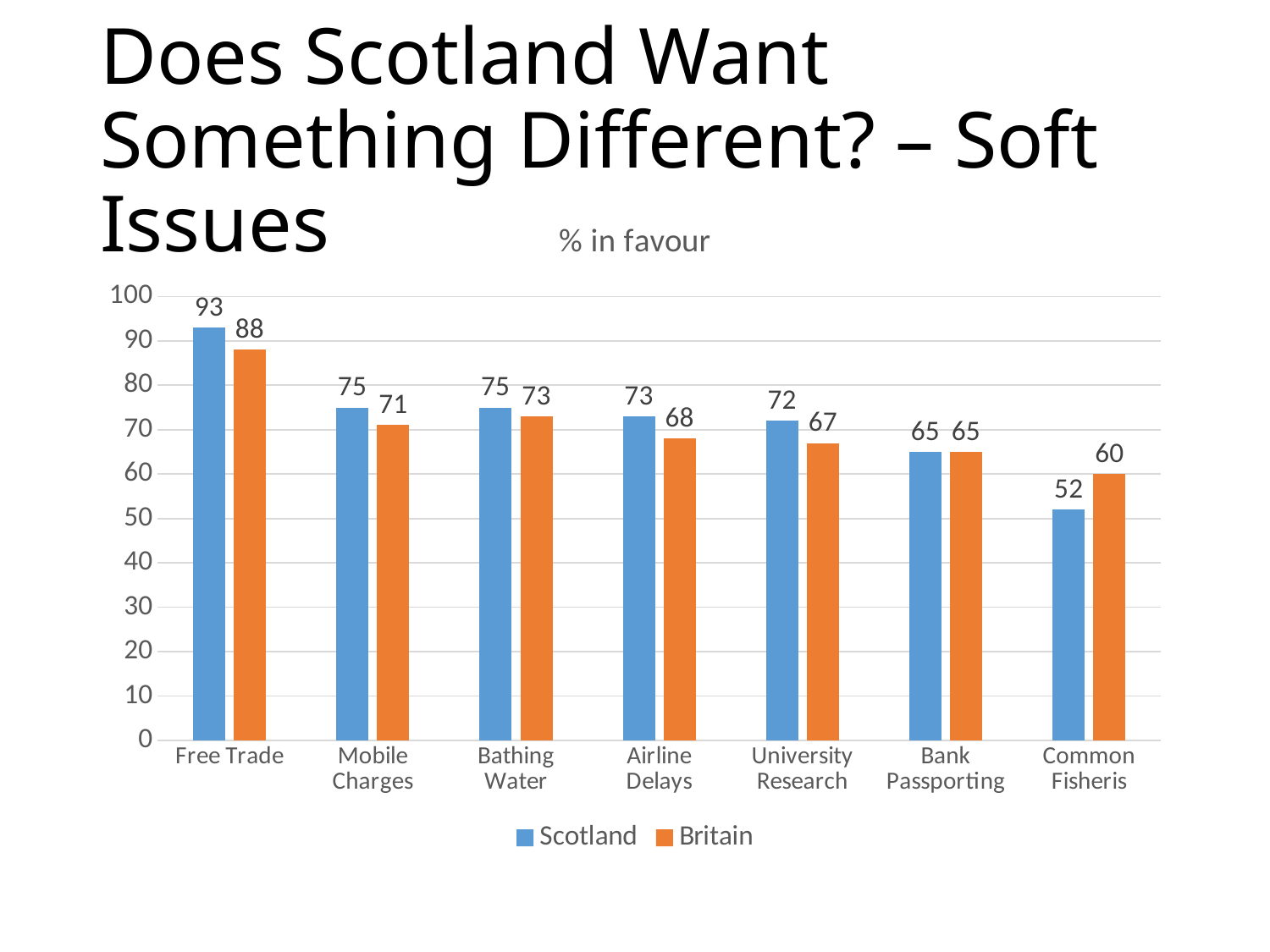
Which category has the highest Britain value? Free Trade What is the Scotland value for Free Trade? 93 What is the Scotland value for Common Fisheris? 52 What is the title of the chart? % in favour What is the difference between the Scotland and Britain values for University Research? 5 What kind of chart is shown on the slide? bar chart Which category has the lowest Scotland value? Common Fisheris How many categories are shown on the x axis? 7 Is the Scotland value for Mobile Charges greater or less than 70? greater Which is larger for Common Fisheris, the Scotland value or the Britain value? Britain What is the Britain value for Airline Delays? 68 How many series does the legend list? 2